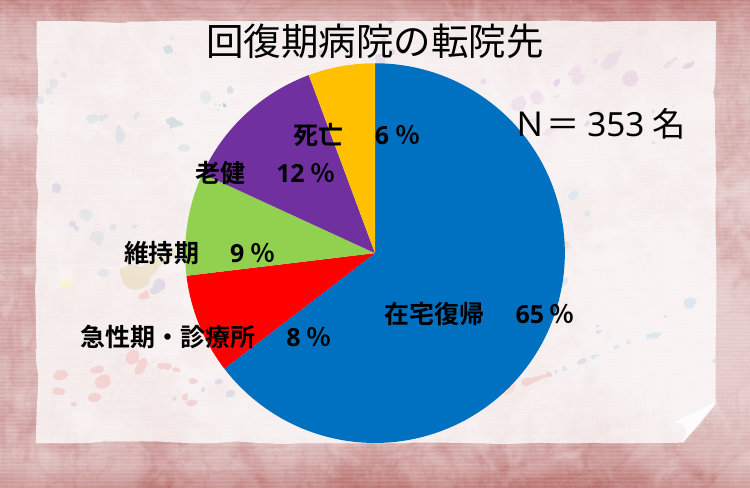
How many categories are shown in the pie chart? 5 What type of chart is shown on the slide? pie chart What percentage of the pie is 在宅復帰? 65% Which is larger, the share for 維持期 or the share for 急性期・診療所? 維持期 What is the difference in percentage points between 老健 and 維持期? 3 What percentage of the pie is 死亡? 6% What percentage of the pie is 急性期・診療所? 8% Which category has the largest share of the pie? 在宅復帰 Which category has the smallest share of the pie? 死亡 What percentage of the pie is 老健? 12% What is the sample size (N) shown on the slide? 353名 What is the title of the pie chart? 回復期病院の転院先